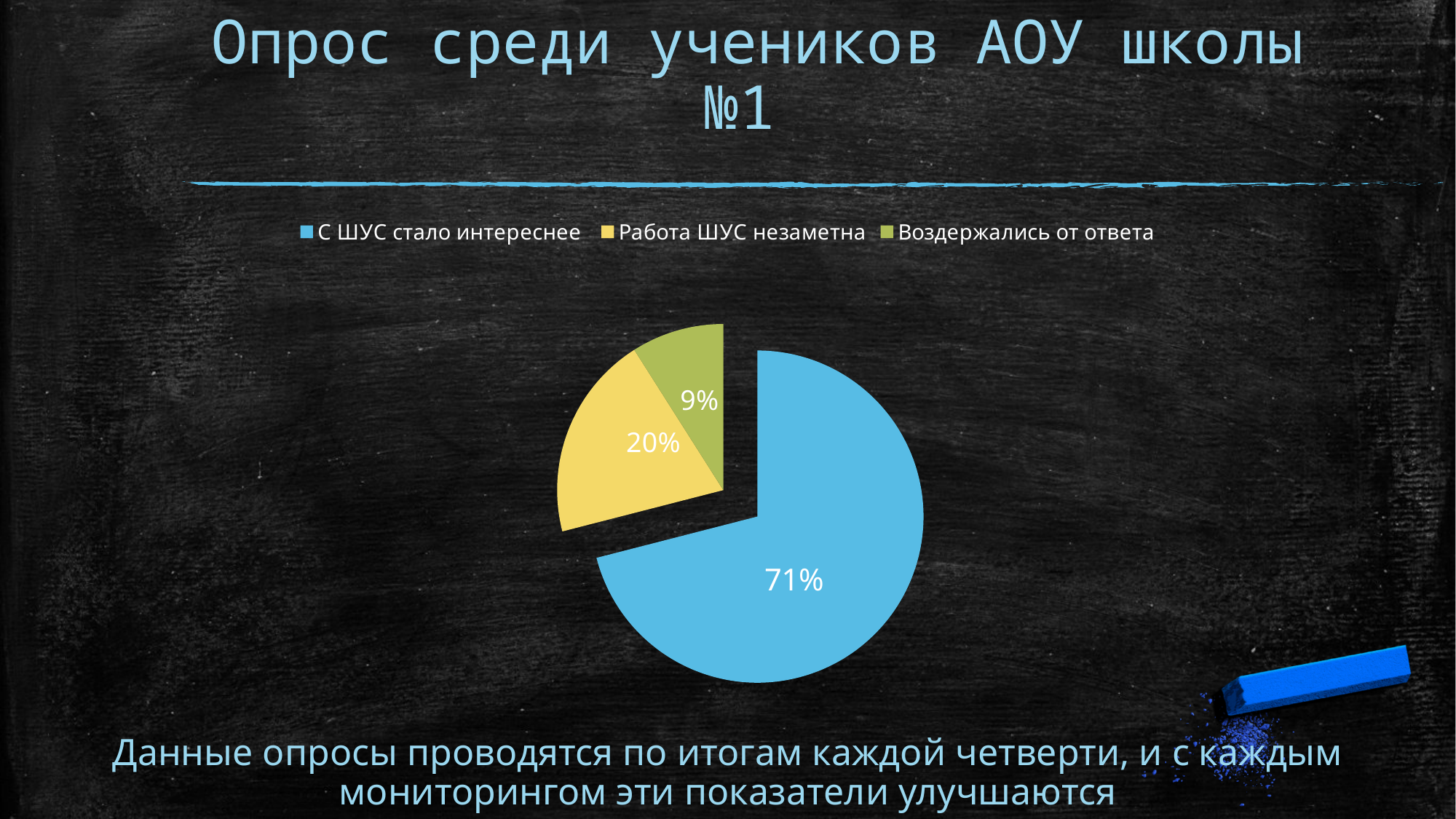
What kind of chart is shown on the slide? pie chart What is the difference in percentage points between 'С ШУС стало интереснее' and 'Работа ШУС незаметна'? 51 How many entries does the legend list? 3 What is the difference in percentage points between 'Работа ШУС незаметна' and 'Воздержались от ответа'? 11 Which is larger: the slice for 'Работа ШУС незаметна' or the slice for 'Воздержались от ответа'? Работа ШУС незаметна What share of the pie is labelled 'С ШУС стало интереснее'? 71% How many slices does the pie chart have? 3 Which category has the smallest slice of the pie? Воздержались от ответа What colour is the slice for 'С ШУС стало интереснее'? blue What share of the pie is labelled 'Воздержались от ответа'? 9% Which category has the largest slice of the pie? С ШУС стало интереснее What share of the pie is labelled 'Работа ШУС незаметна'? 20%